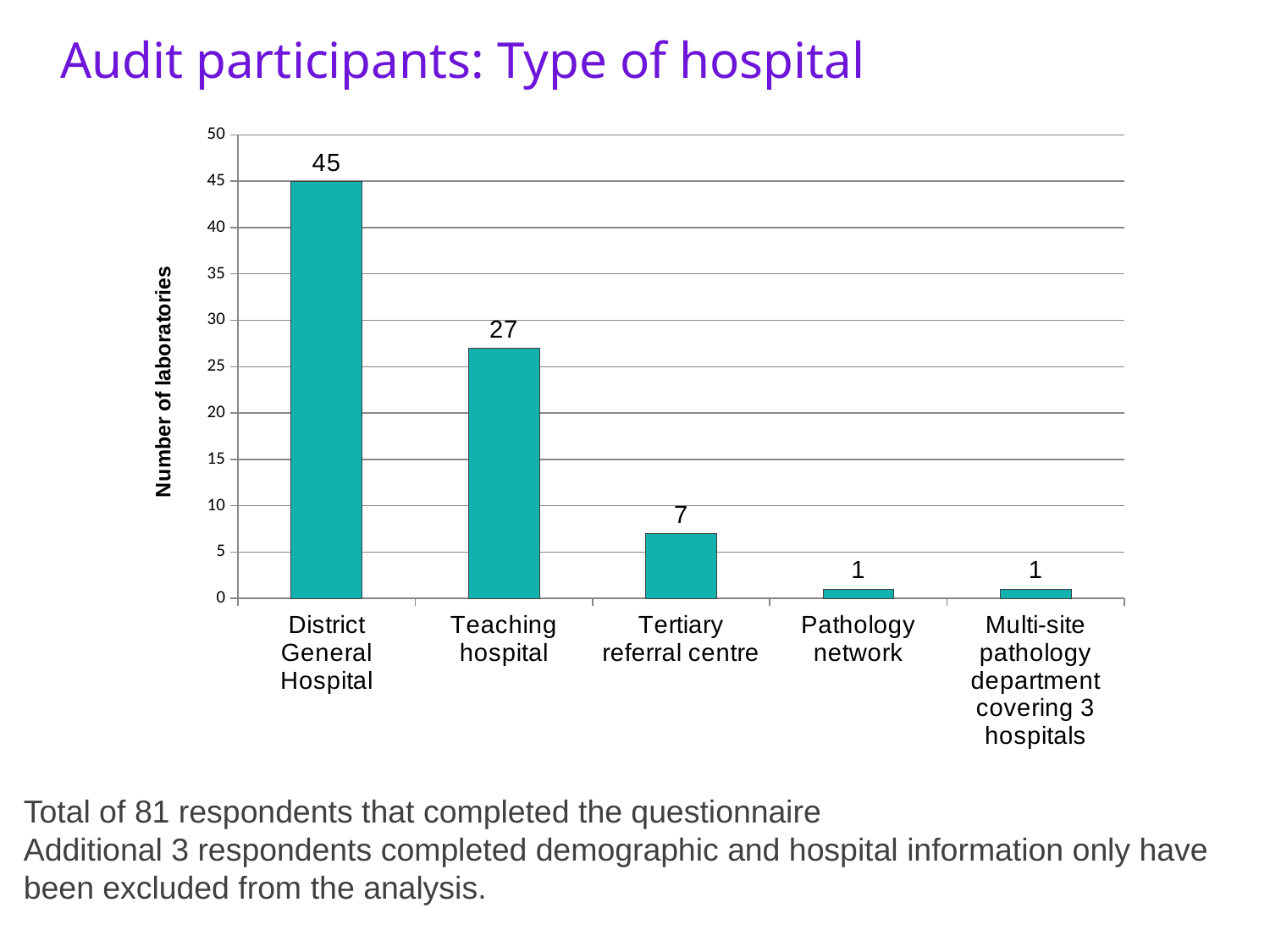
What is the label of the vertical axis? Number of laboratories What is the number of laboratories for Teaching hospital? 27 What is the difference between the values for Teaching hospital and Tertiary referral centre? 20 What is the value for Tertiary referral centre? 7 What kind of chart is shown on the slide? bar chart Which is larger, the value for Teaching hospital or Tertiary referral centre? Teaching hospital Is the value for Teaching hospital greater or less than 30? less What is the difference between the number of laboratories for District General Hospital and Teaching hospital? 18 How many hospital type categories are shown on the chart? 5 How many laboratories are District General Hospitals? 45 How many laboratories are in a Pathology network? 1 Which type of hospital has the highest number of laboratories? District General Hospital